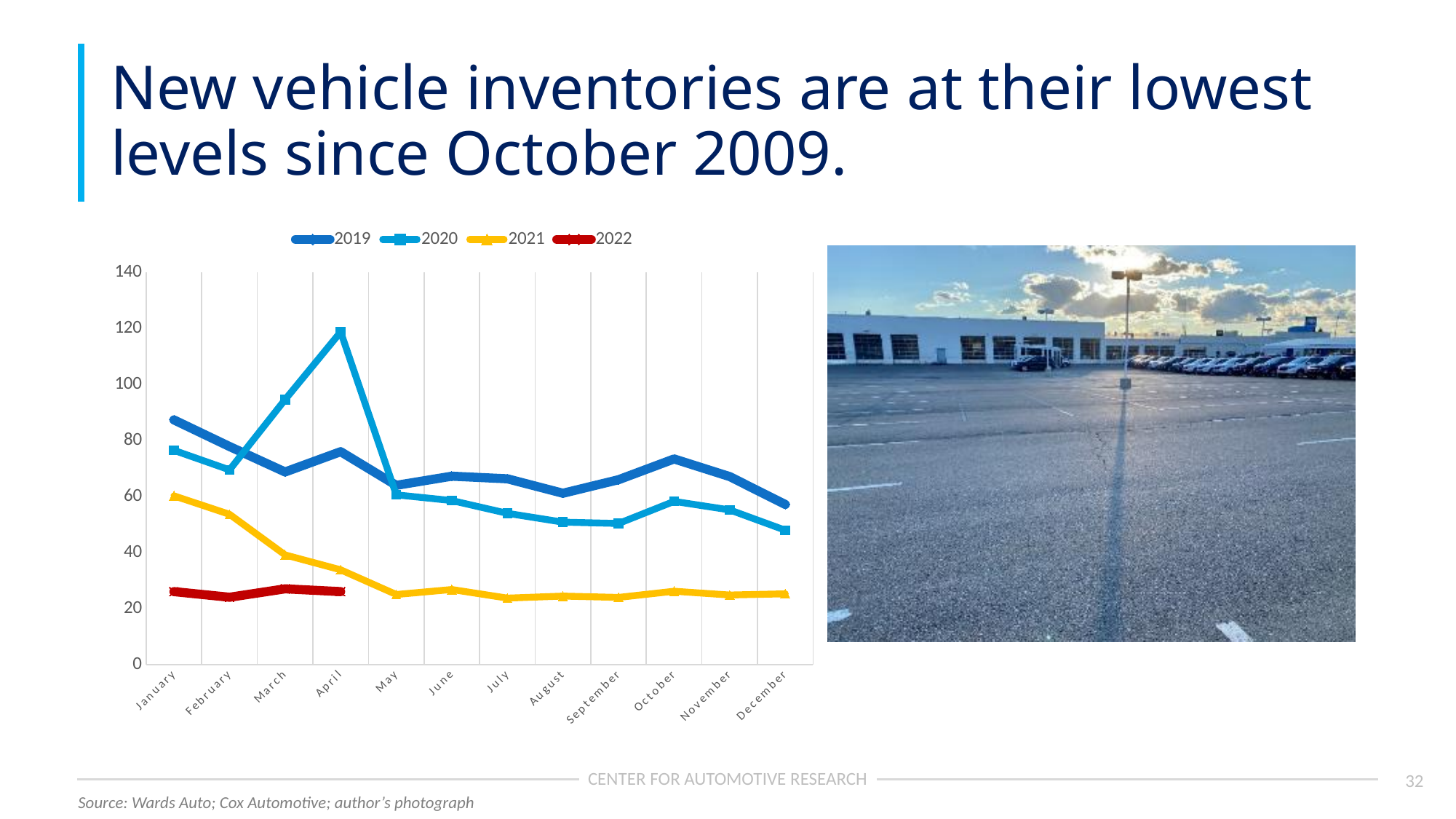
Which series is drawn in red? 2022 How many series does the legend list? 4 Is the value for 2020 in April greater or less than 100? greater What kind of chart is shown on the slide? line chart Which is larger in June, the value for 2019 or the value for 2021? 2019 Is the value for 2019 in January greater or less than 80? greater Does the 2021 series rise or fall from January to May? fall In which month does the 2020 series reach its highest value? April Which series has the highest value in April? 2020 How many months are shown along the x axis? 12 Is the value for 2022 in March greater or less than 40? less Which series has the lowest value in January? 2022